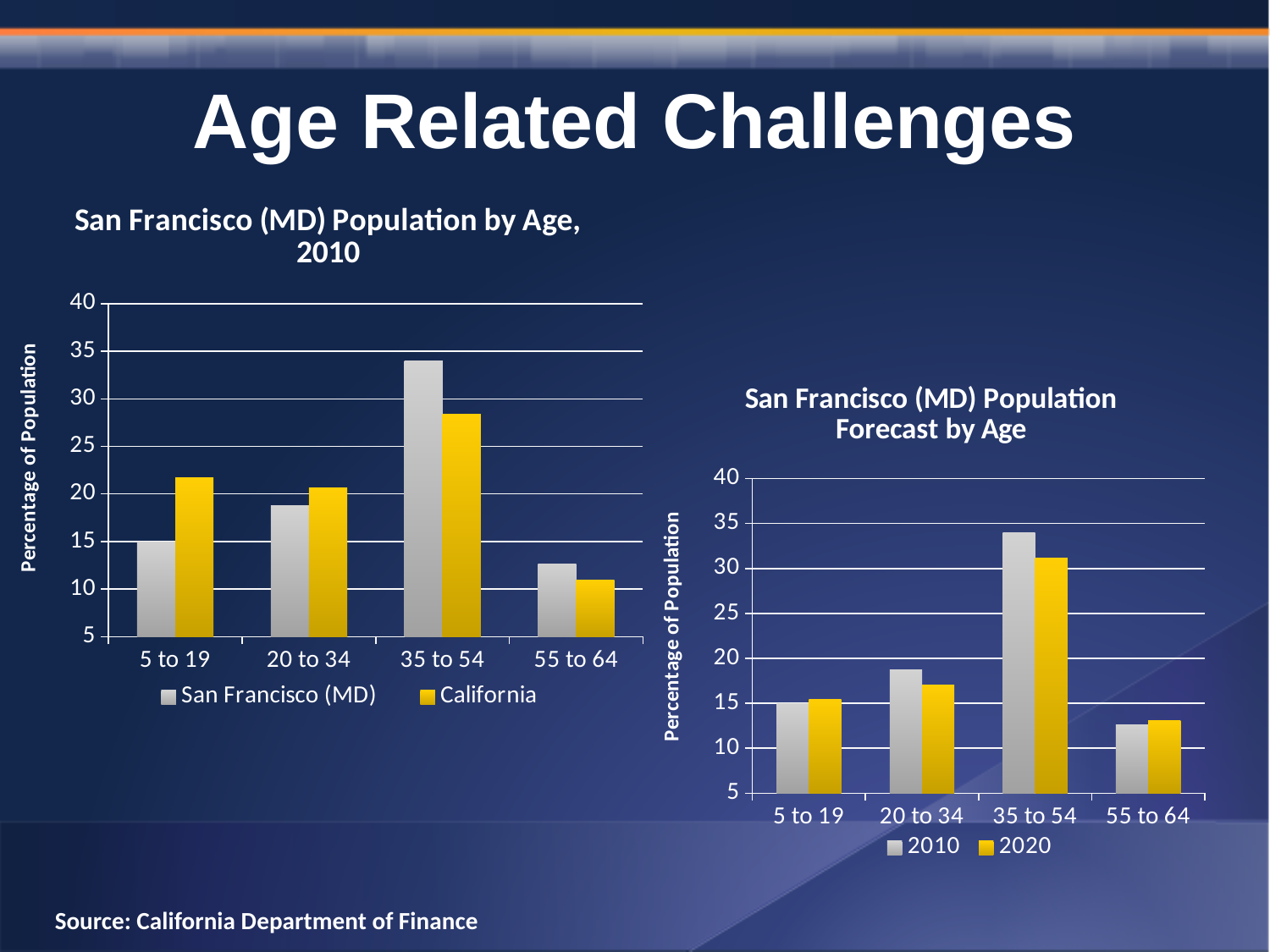
In the right chart, 'San Francisco (MD) Population Forecast by Age', what are the two series listed in the legend? 2010 and 2020 In the right chart, 'San Francisco (MD) Population Forecast by Age', is the 2020 value for 20 to 34 greater or less than 20? less In the left chart, 'San Francisco (MD) Population by Age, 2010', how many age categories are shown on the x axis? 4 What kind of chart is the 'San Francisco (MD) Population by Age, 2010' chart on the left? bar chart In the left chart, 'San Francisco (MD) Population by Age, 2010', which age group has the lowest California value? 55 to 64 In the left chart, 'San Francisco (MD) Population by Age, 2010', for the 5 to 19 age group, which is larger: San Francisco (MD) or California? California In the left chart, 'San Francisco (MD) Population by Age, 2010', is the San Francisco (MD) value for 35 to 54 greater or less than 30? greater In the left chart, 'San Francisco (MD) Population by Age, 2010', how many series does the legend list? 2 In the right chart, 'San Francisco (MD) Population Forecast by Age', for the 35 to 54 age group, which is larger: 2010 or 2020? 2010 In the left chart, 'San Francisco (MD) Population by Age, 2010', which age group has the highest San Francisco (MD) value? 35 to 54 What is the label on the vertical axis of the right chart, 'San Francisco (MD) Population Forecast by Age'? Percentage of Population In the left chart, 'San Francisco (MD) Population by Age, 2010', for the 35 to 54 age group, which is larger: San Francisco (MD) or California? San Francisco (MD)